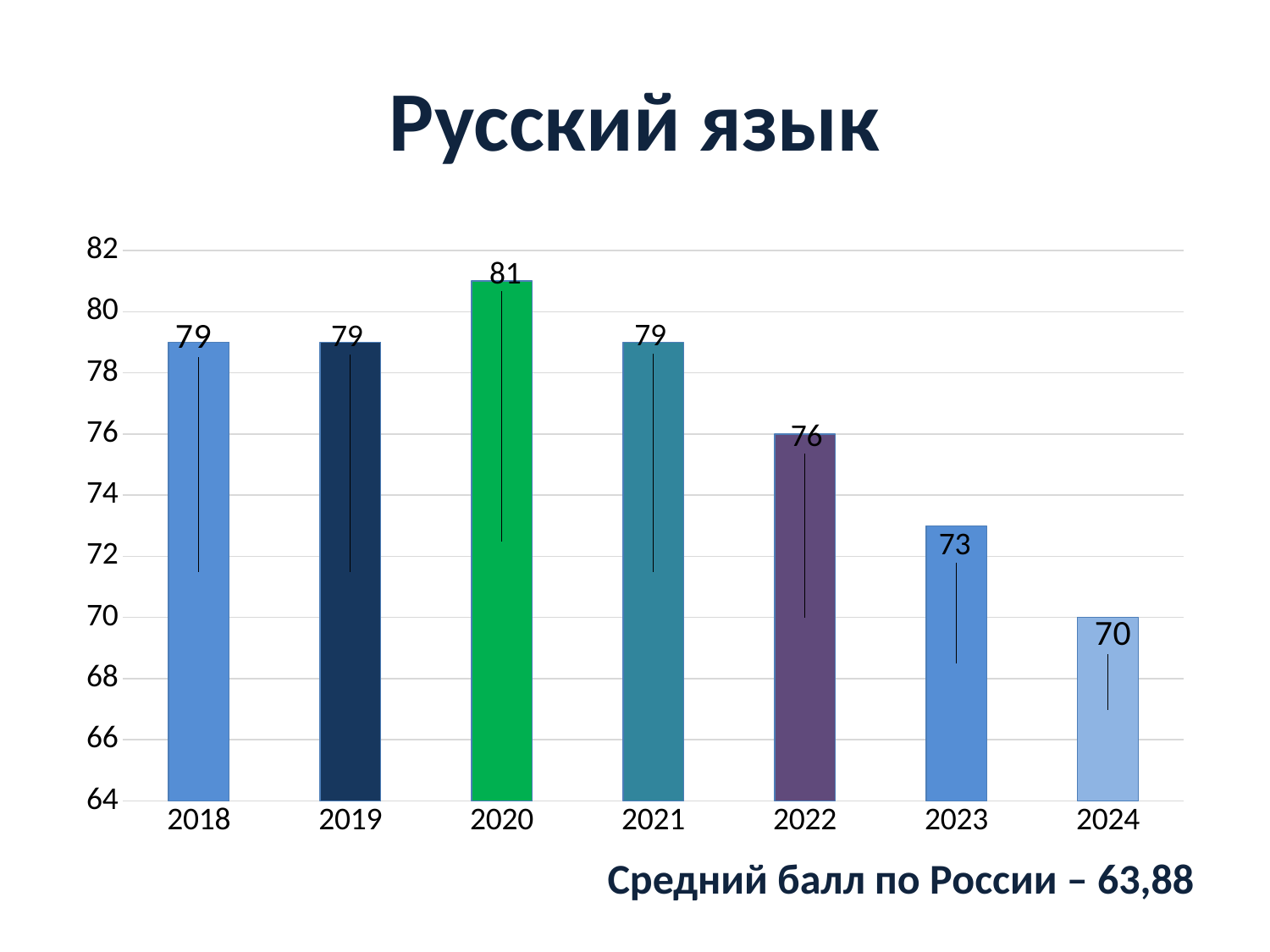
What is the value for 2022? 76 Which is larger, the value for 2021 or the value for 2022? 2021 What is the value for 2024? 70 What is the difference between the values for 2022 and 2023? 3 How many years are shown on the x axis? 7 Is the value for 2023 greater or less than 74? less Which year has the lowest value? 2024 Which year has the highest value? 2020 What kind of chart is shown on the slide? bar chart What is the title of the chart? Русский язык What is the difference between the values for 2020 and 2024? 11 What is the value for 2020? 81